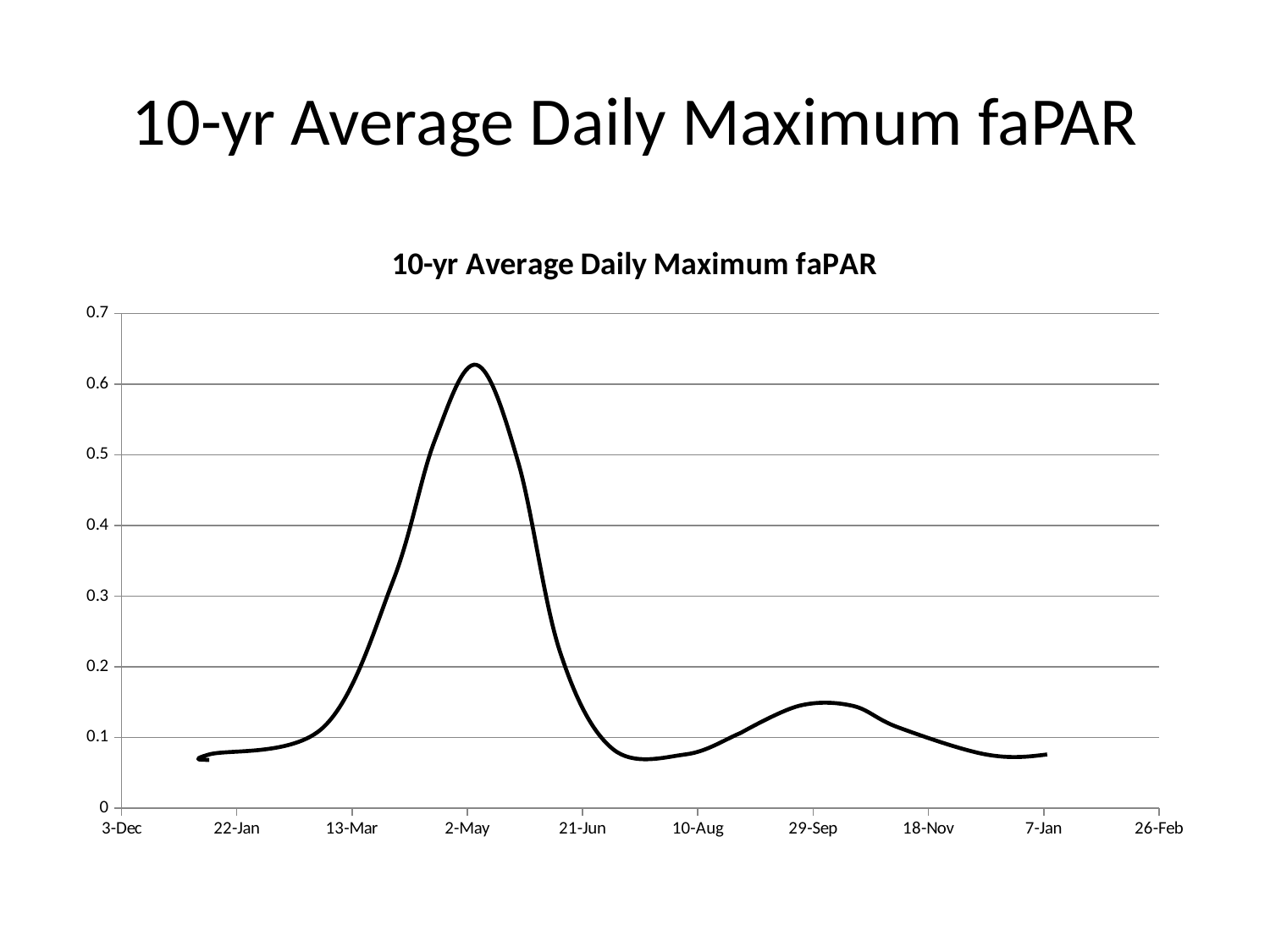
What is the title of the chart? 10-yr Average Daily Maximum faPAR Is the value at 2-May greater or less than 0.5? greater How many date labels are shown on the x axis? 10 Is the value at 29-Sep greater or less than 0.2? less Which is larger, the value at 2-May or the value at 29-Sep? 2-May Near which x-axis date label does the line reach its highest value? 2-May Between 2-May and 21-Jun, does the line rise or fall? fall Is the value at 13-Mar greater or less than 0.2? less What kind of chart is shown on the slide? line chart